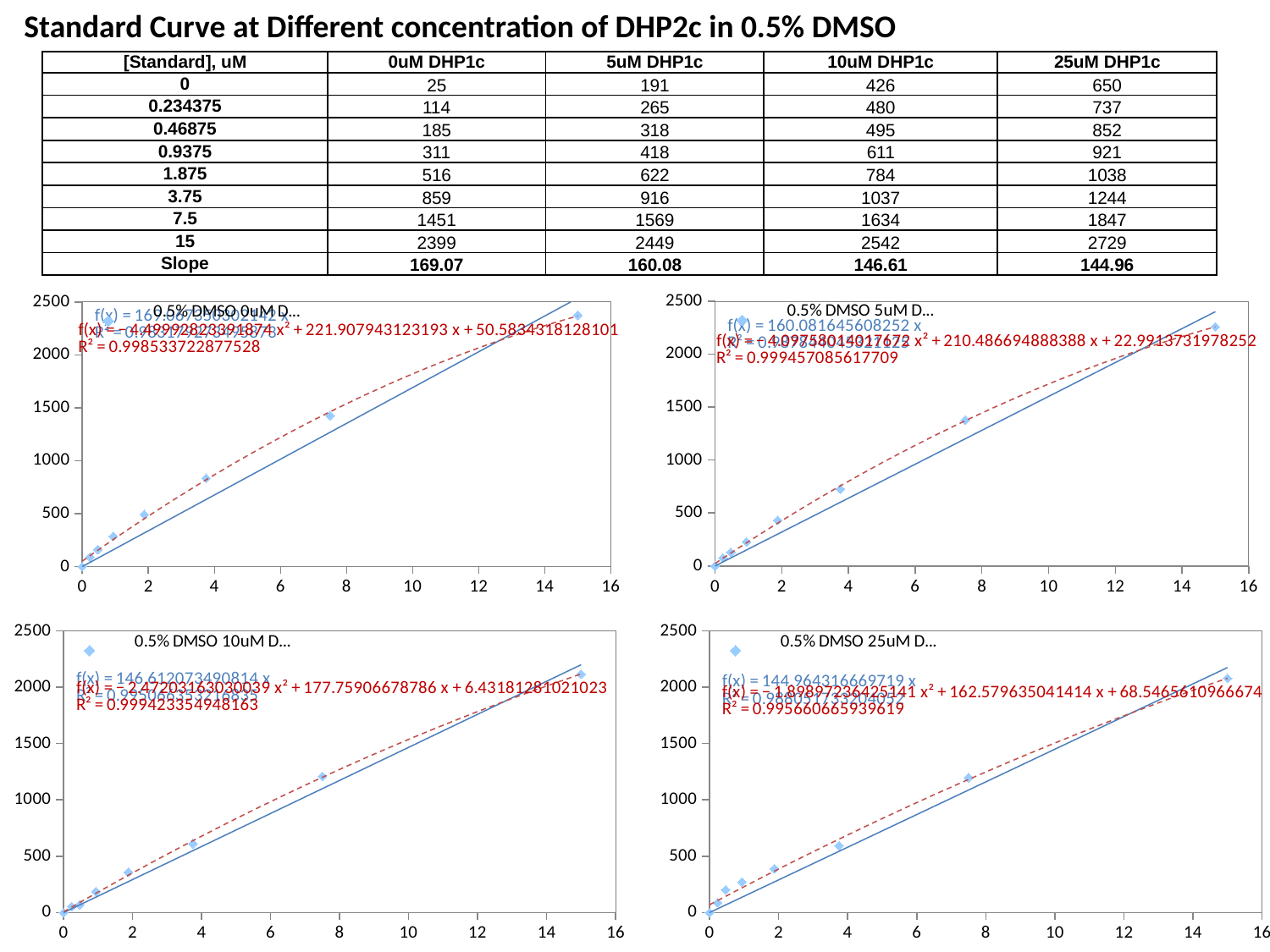
What kind of chart is the top-left chart titled "0.5% DMSO 0uM D..."? Scatter chart In the top-right chart titled "0.5% DMSO 5uM D...", is the value of the point at x = 7.5 greater or less than 1500? less In the bottom-left chart titled "0.5% DMSO 10uM D...", is the value of the point at x = 7.5 greater or less than 1000? greater In the top-right chart titled "0.5% DMSO 5uM D...", do the plotted values rise or fall as x increases? Rise What is the title of the bottom-right chart? 0.5% DMSO 25uM D... What is the R² value shown in red on the bottom-left chart titled "0.5% DMSO 10uM D..."? 0.999423354948163 In the bottom-right chart titled "0.5% DMSO 25uM D...", at which x value is the highest plotted point? 15 In the bottom-right chart titled "0.5% DMSO 25uM D...", is the value of the point at x = 3.75 greater or less than 1000? less How many data points are plotted in the bottom-left chart titled "0.5% DMSO 10uM D..."? 8 In the top-right chart titled "0.5% DMSO 5uM D...", which point has a larger value: the one at x = 7.5 or the one at x = 15? x = 15